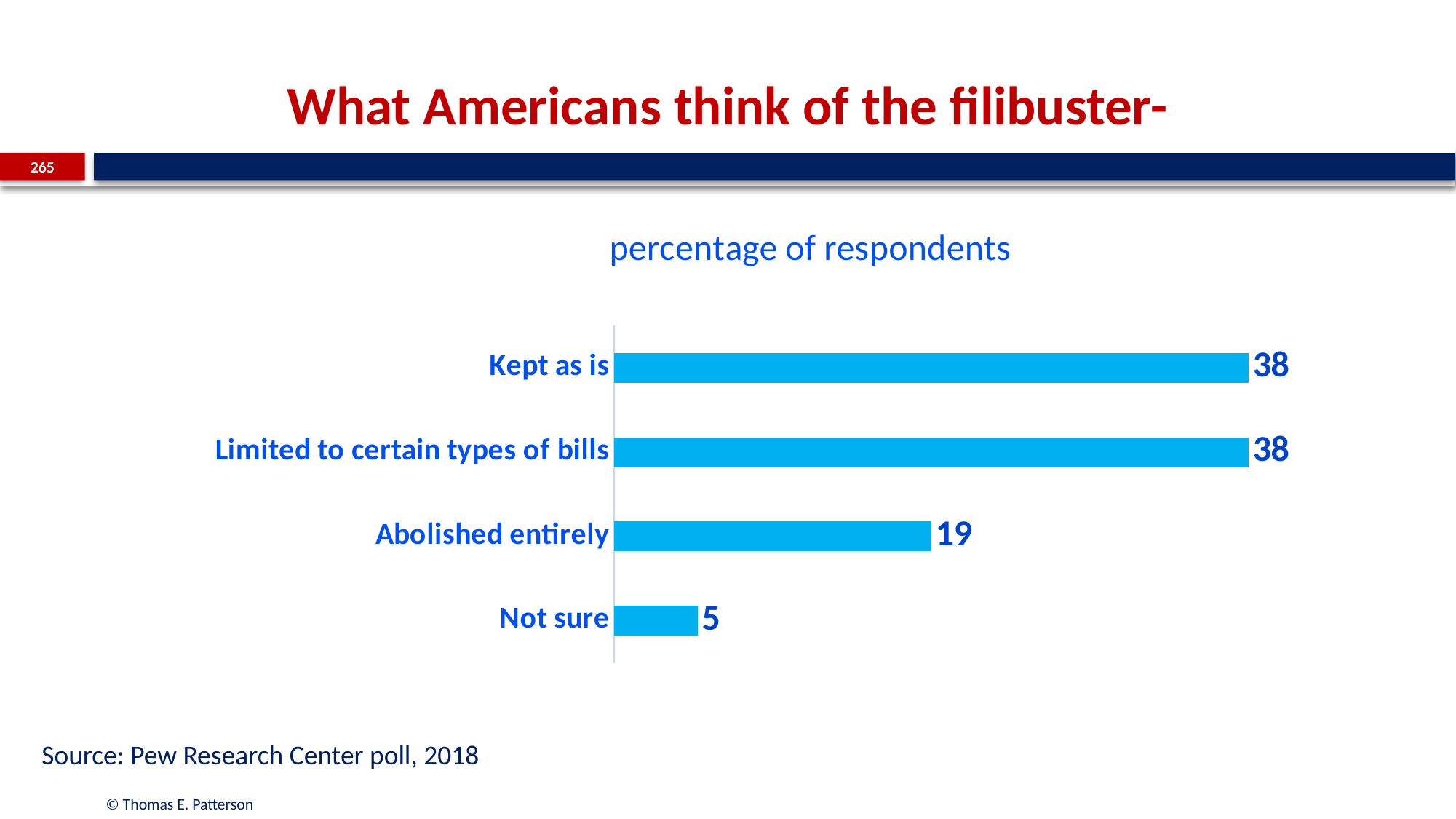
What is the difference between the values for "Kept as is" and "Abolished entirely"? 19 Which is larger, the value for "Abolished entirely" or the value for "Not sure"? Abolished entirely What kind of chart is shown on the slide? Bar chart Which category has the lowest value? Not sure What is the value for "Abolished entirely"? 19 What is the difference between the values for "Abolished entirely" and "Not sure"? 14 What is the value for "Not sure"? 5 What is the title of the chart? percentage of respondents What is the value for "Limited to certain types of bills"? 38 Which is larger, the value for "Limited to certain types of bills" or the value for "Abolished entirely"? Limited to certain types of bills How many categories are shown in the chart? 4 What is the value for "Kept as is"? 38